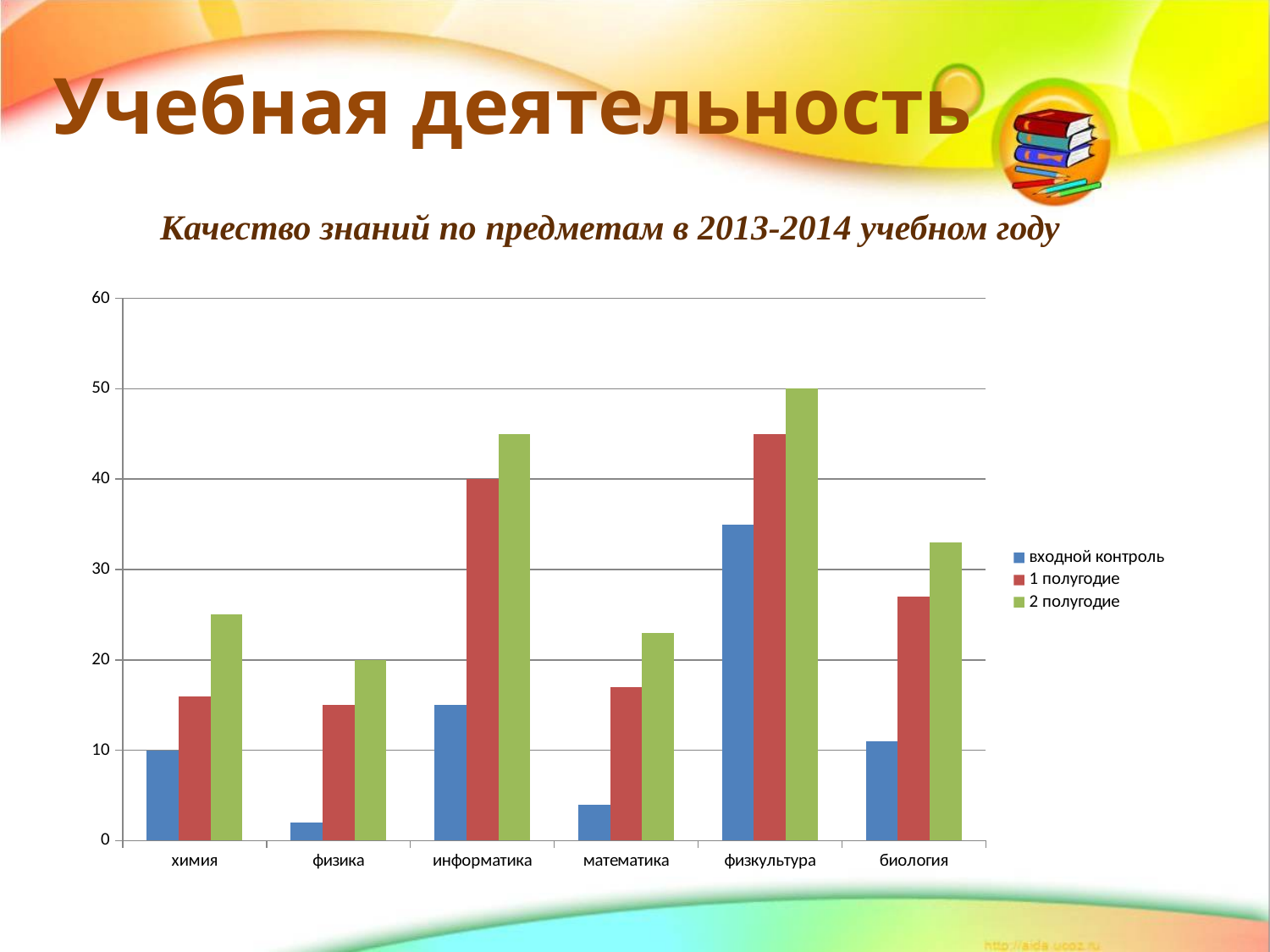
How many subjects (categories) are shown on the x axis? 6 Which is larger: the 1 полугодие value for физкультура or the 1 полугодие value for биология? физкультура How many series does the legend list? 3 Is the value for биология in the 2 полугодие series greater or less than 30? greater Which subject has the highest value in the 2 полугодие series? физкультура What kind of chart is shown on the slide? bar chart Is the value for математика in the входной контроль series greater or less than 10? less What is the value for информатика in the 1 полугодие series? 40 What is the title of the chart? Качество знаний по предметам в 2013-2014 учебном году What is the value for химия in the входной контроль series? 10 Which subject has the lowest value in the входной контроль series? физика What is the value for физкультура in the 2 полугодие series? 50